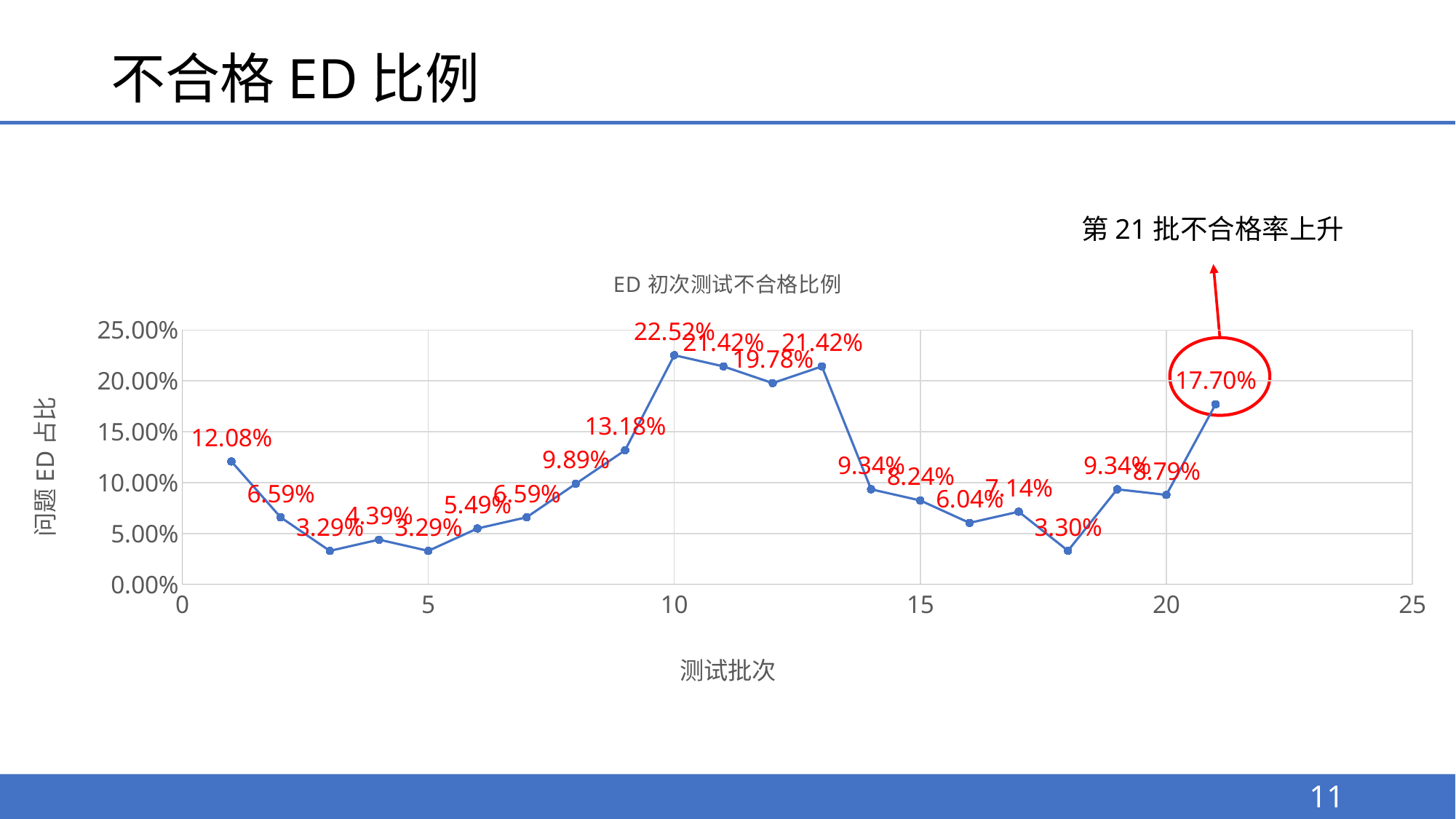
What is the title of the chart? ED 初次测试不合格比例 Which is larger, the value for batch 9 or the value for batch 14? batch 9 Which test batch has the highest value? 10 How many test batches are plotted on the chart? 21 Do the values rise or fall from batch 13 to batch 18? fall What is the value for test batch 21, the circled point? 17.70% What kind of chart is shown on the slide? line chart What is the value for test batch 1? 12.08% What is the value for test batch 10? 22.52% What is the lowest value plotted on the chart? 3.29% What is the value for test batch 12? 19.78% What is the difference between the value for batch 10 and the value for batch 21? 4.82%